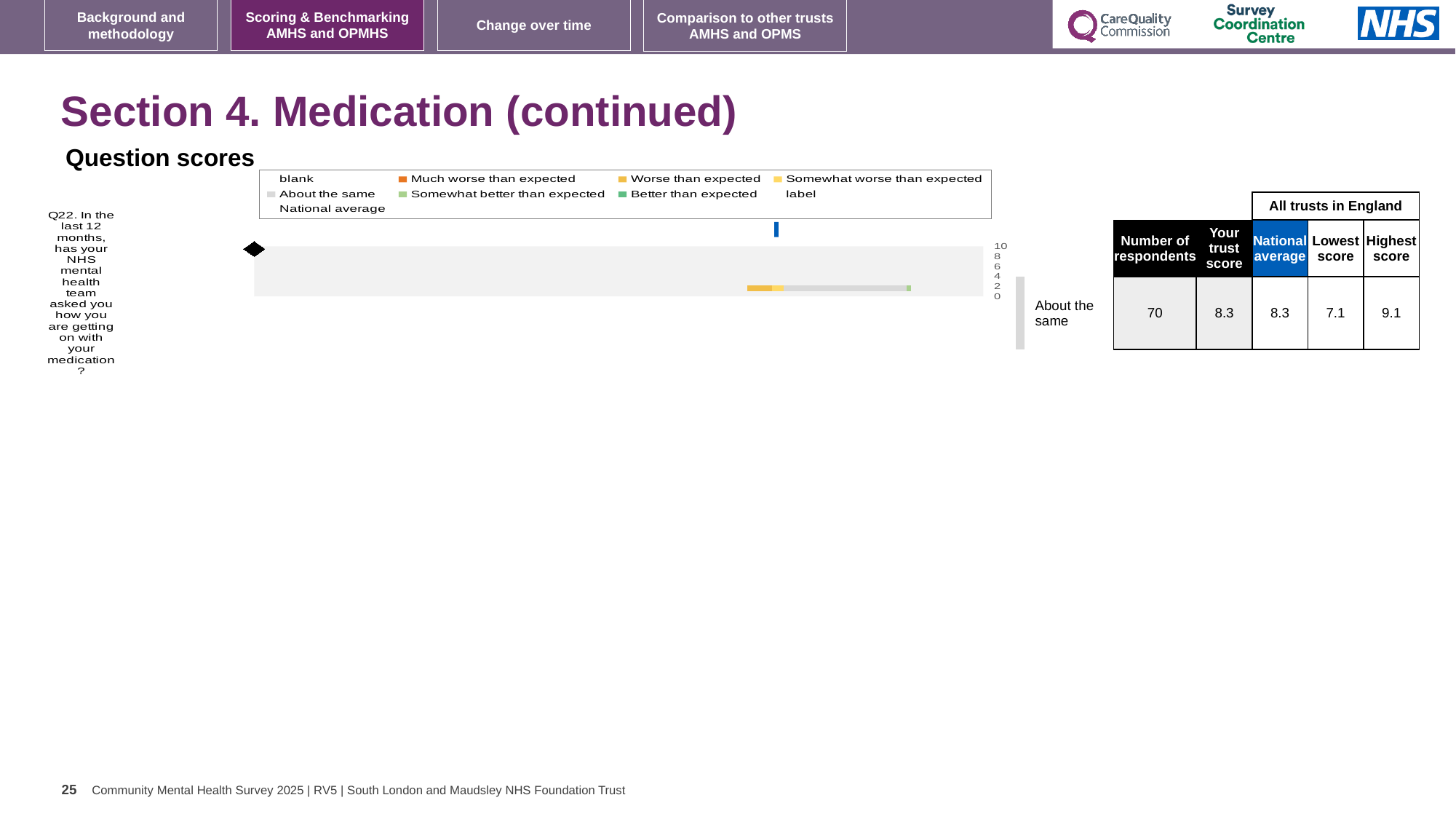
What kind of chart is shown on the slide? bar chart What benchmark category label is shown to the right of the chart for Q22? About the same What is the highest tick value shown on the chart's axis? 10 In the table beside the chart, what is the lowest score among all trusts in England for Q22? 7.1 How many entries does the chart's legend list? 9 In the table beside the chart, what is the highest score among all trusts in England for Q22? 9.1 In the table beside the chart, what is the number of respondents for Q22? 70 Which question is plotted on the chart? Q22. In the last 12 months, has your NHS mental health team asked you how you are getting on with your medication? In the table beside the chart, what is your trust score for Q22? 8.3 In the table beside the chart, what is the difference between the highest score and the lowest score for Q22? 2.0 In the table beside the chart, what is the national average for Q22? 8.3 How many questions (categories) are plotted on the chart? 1